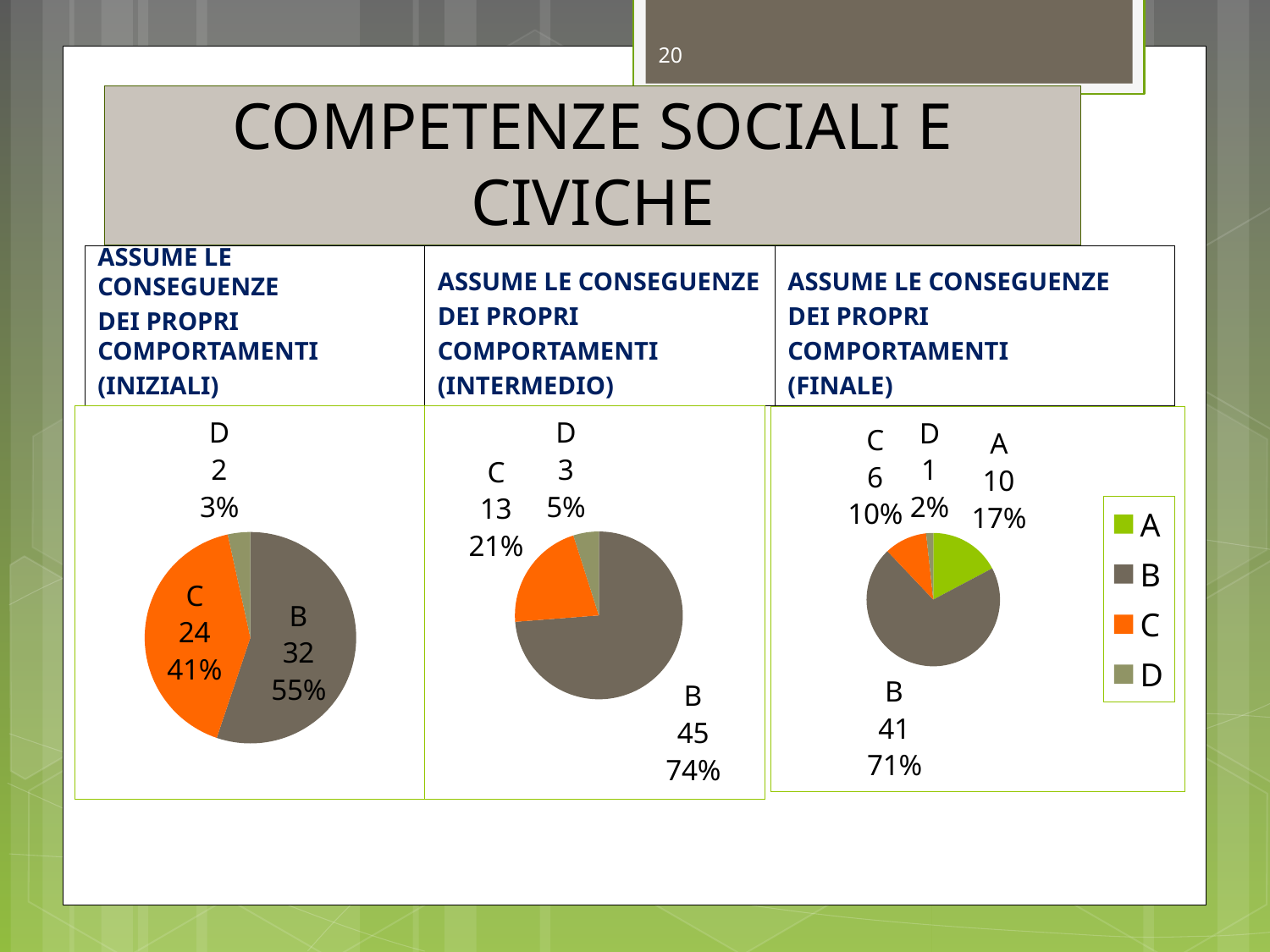
In the FINALE pie chart, how many categories are shown? 4 What kind of chart is used in the INIZIALI panel? Pie chart In the INIZIALI pie chart, what share of the pie does category C represent? 41% In the FINALE pie chart, what is the value for category A? 10 In the INTERMEDIO pie chart, what share of the pie does category B represent? 74% In the FINALE pie chart, which is larger, the value for C or the value for D? C In the INIZIALI pie chart, what is the value for category B? 32 How many entries does the legend next to the FINALE chart list? 4 In the FINALE pie chart, which category is the largest? B In the INIZIALI pie chart, which category is the smallest? D In the INTERMEDIO pie chart, what is the difference between the values for B and C? 32 In the INTERMEDIO pie chart, what is the value for category C? 13